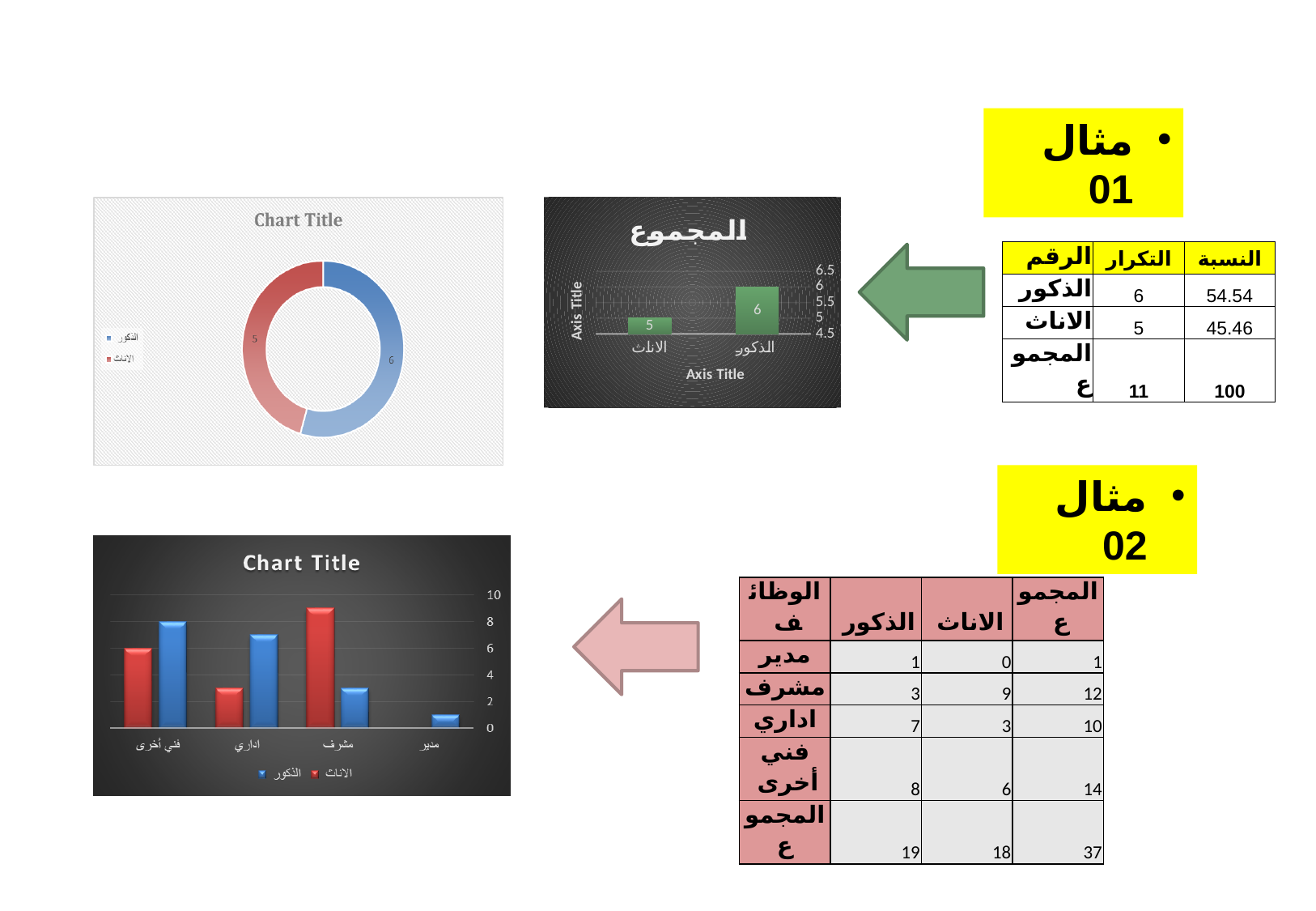
In the chart titled المجموع, what is the difference between the values for الذكور and الاناث? 1 In the doughnut chart at the top left, how many series does the legend list? 2 In the bottom-left bar chart, which category has the tallest red bar? مشرف In the bottom-left bar chart, how many categories are shown on the x axis? 4 In the doughnut chart at the top left, what is the value for الاناث? 5 What kind of chart is the chart titled المجموع? bar chart In the chart titled المجموع, what is the value for الاناث? 5 In the doughnut chart at the top left, what is the value for الذكور? 6 In the chart titled المجموع, which category has the higher value? الذكور In the bottom-left bar chart, is the blue bar for مدير greater or less than 2? less In the bottom-left bar chart, how many series does the legend list? 2 In the bottom-left bar chart, is the red bar for مشرف greater or less than 8? greater